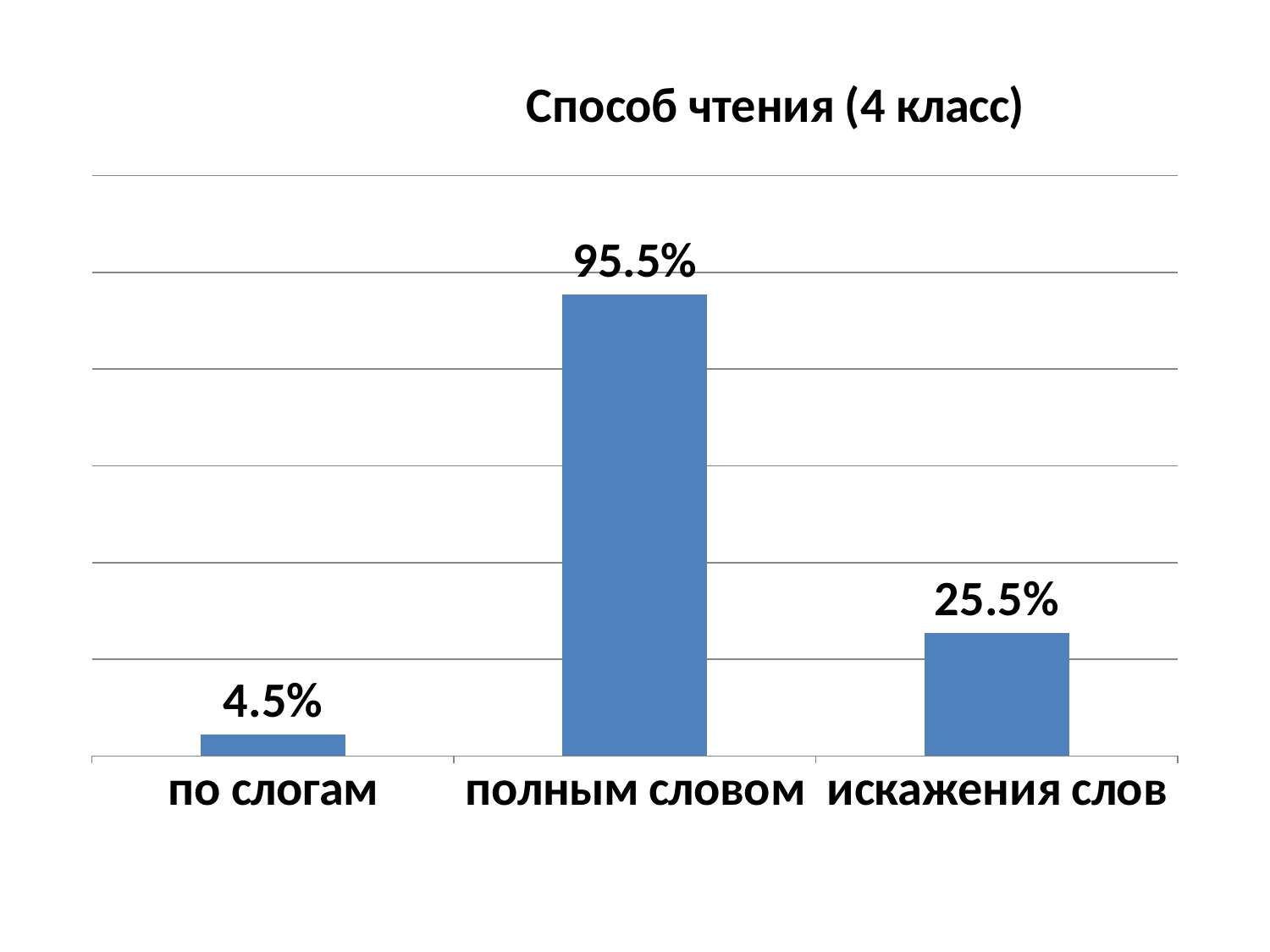
What colour are the bars in the chart? blue What is the value for "полным словом"? 95.5% What is the difference between the values for "искажения слов" and "по слогам"? 21% How many categories are shown on the chart? 3 What kind of chart is shown on the slide? bar chart What is the value for "искажения слов"? 25.5% Which category has the lowest value? по слогам What is the title of the chart? Способ чтения (4 класс) Which category has the highest value? полным словом What is the value for "по слогам"? 4.5% Which is larger, the value for "искажения слов" or the value for "по слогам"? искажения слов What is the difference between the values for "полным словом" and "искажения слов"? 70%